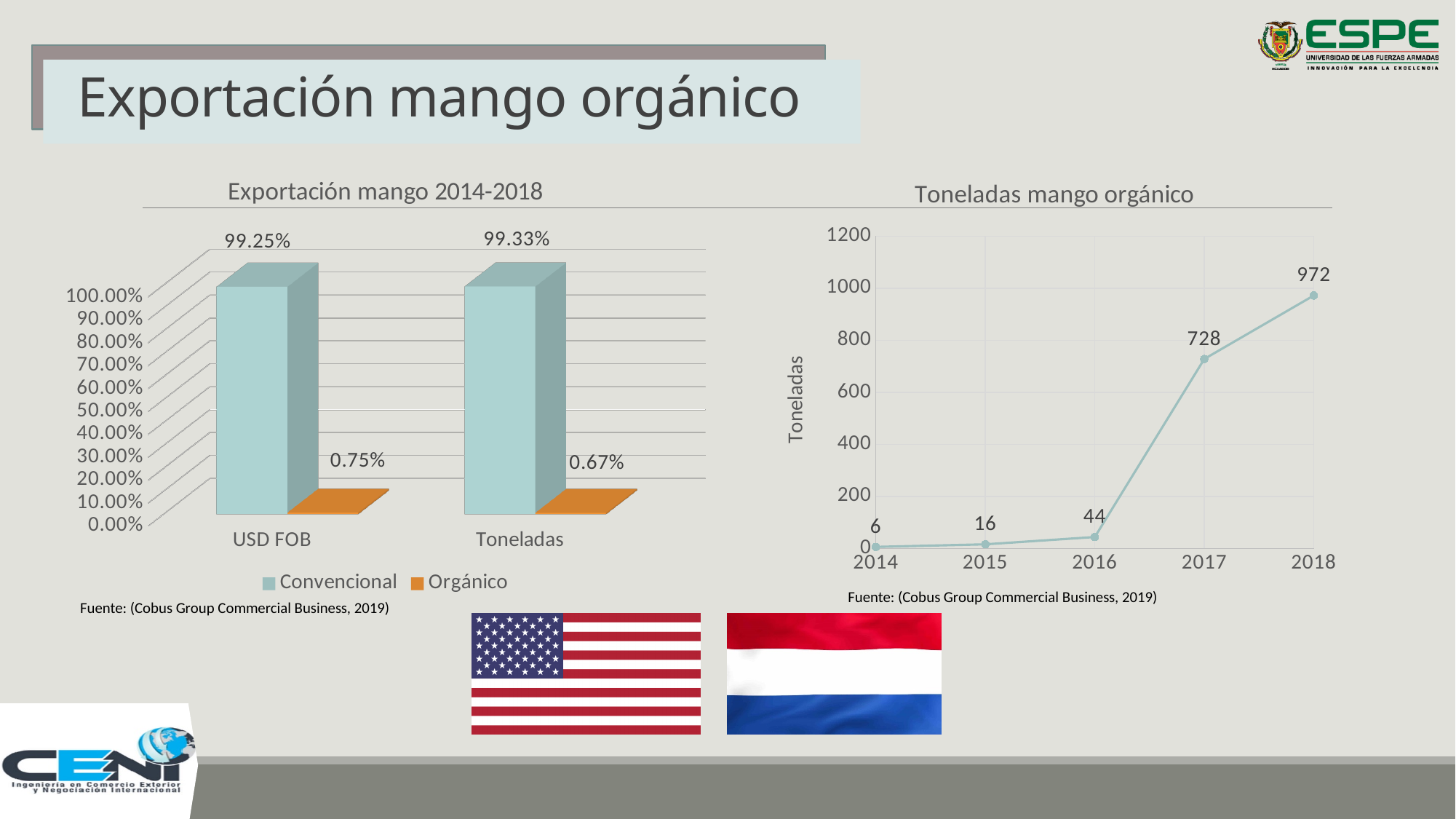
In the 'Toneladas mango orgánico' chart, what is the difference between the values for 2018 and 2017? 244 In the 'Toneladas mango orgánico' chart, what is the value for 2017? 728 In the 'Toneladas mango orgánico' chart, what is the value for 2015? 16 In the 'Exportación mango 2014-2018' chart, which series is larger in the Toneladas category, Convencional or Orgánico? Convencional In the 'Exportación mango 2014-2018' chart, what is the value for Convencional in the USD FOB category? 99.25% In the 'Exportación mango 2014-2018' chart, what kind of chart is shown? Bar chart In the 'Exportación mango 2014-2018' chart, what is the value for Orgánico in the USD FOB category? 0.75% In the 'Toneladas mango orgánico' chart, which year has the highest value? 2018 In the 'Toneladas mango orgánico' chart, which year has the lowest value? 2014 In the 'Toneladas mango orgánico' chart, do the values rise or fall from 2014 to 2018? Rise In the 'Exportación mango 2014-2018' chart, what is the value for Orgánico in the Toneladas category? 0.67% In the 'Exportación mango 2014-2018' chart, how many series does the legend list? 2